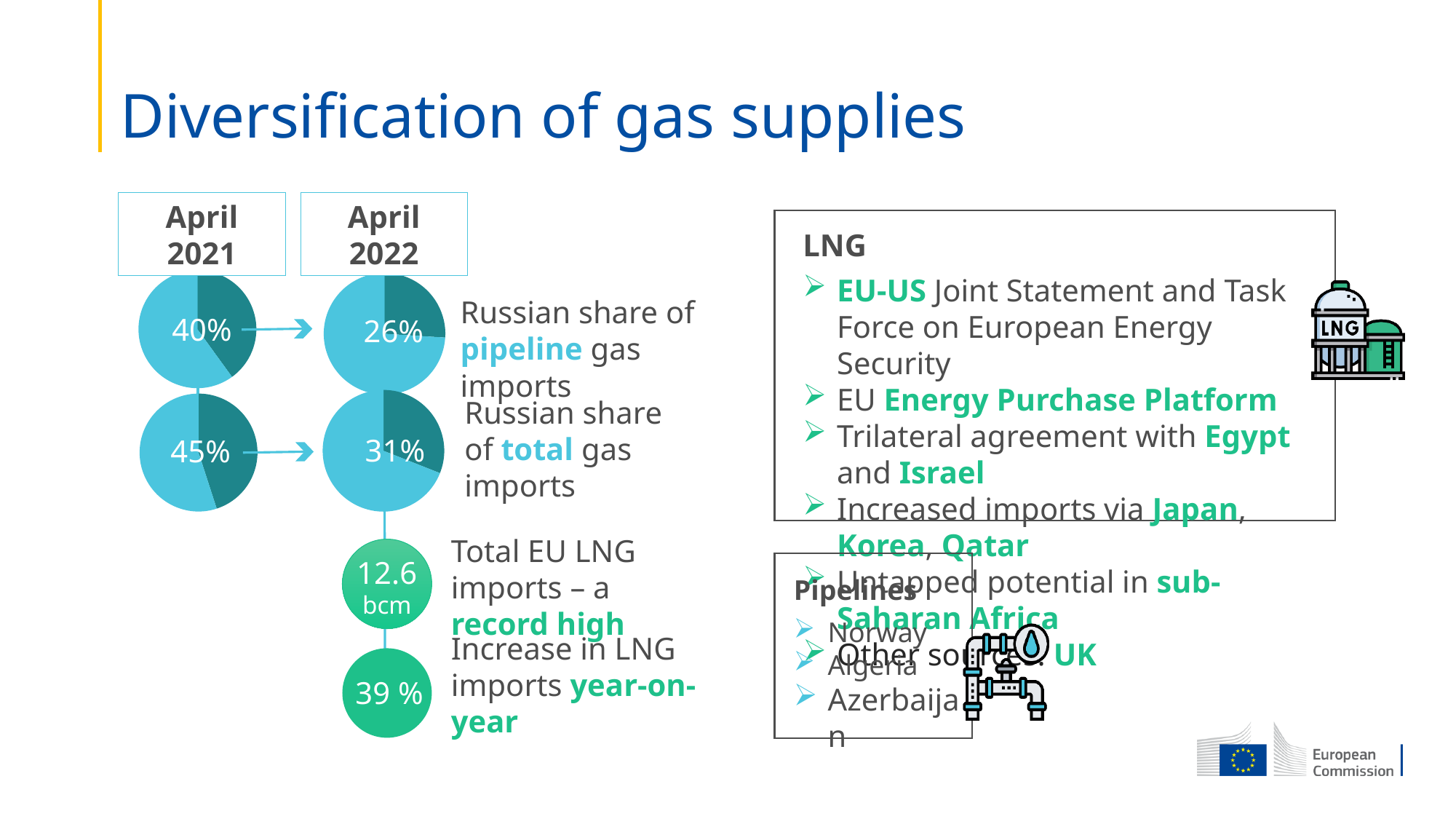
In the pie chart for the Russian share of total gas imports in April 2021, what share is shown? 45% Did the Russian share of pipeline gas imports rise or fall from April 2021 to April 2022? fall What kind of charts are used to show the Russian share of pipeline and total gas imports? pie charts Which is larger in April 2022: the Russian share of pipeline gas imports or the Russian share of total gas imports? Russian share of total gas imports In the pie chart for the Russian share of pipeline gas imports in April 2021, what share is shown? 40% Which two time periods are compared in the pie charts? April 2021 and April 2022 Which of the four pie charts shows the highest Russian share? Russian share of total gas imports, April 2021 (45%) In the pie chart for the Russian share of pipeline gas imports in April 2022, what share is shown? 26% In the pie chart for the Russian share of total gas imports in April 2022, what share is shown? 31% By how many percentage points did the Russian share of total gas imports fall between April 2021 and April 2022, according to the pie charts? 14 percentage points By how many percentage points did the Russian share of pipeline gas imports fall between April 2021 and April 2022, according to the pie charts? 14 percentage points How many pie charts are shown on the slide? 4